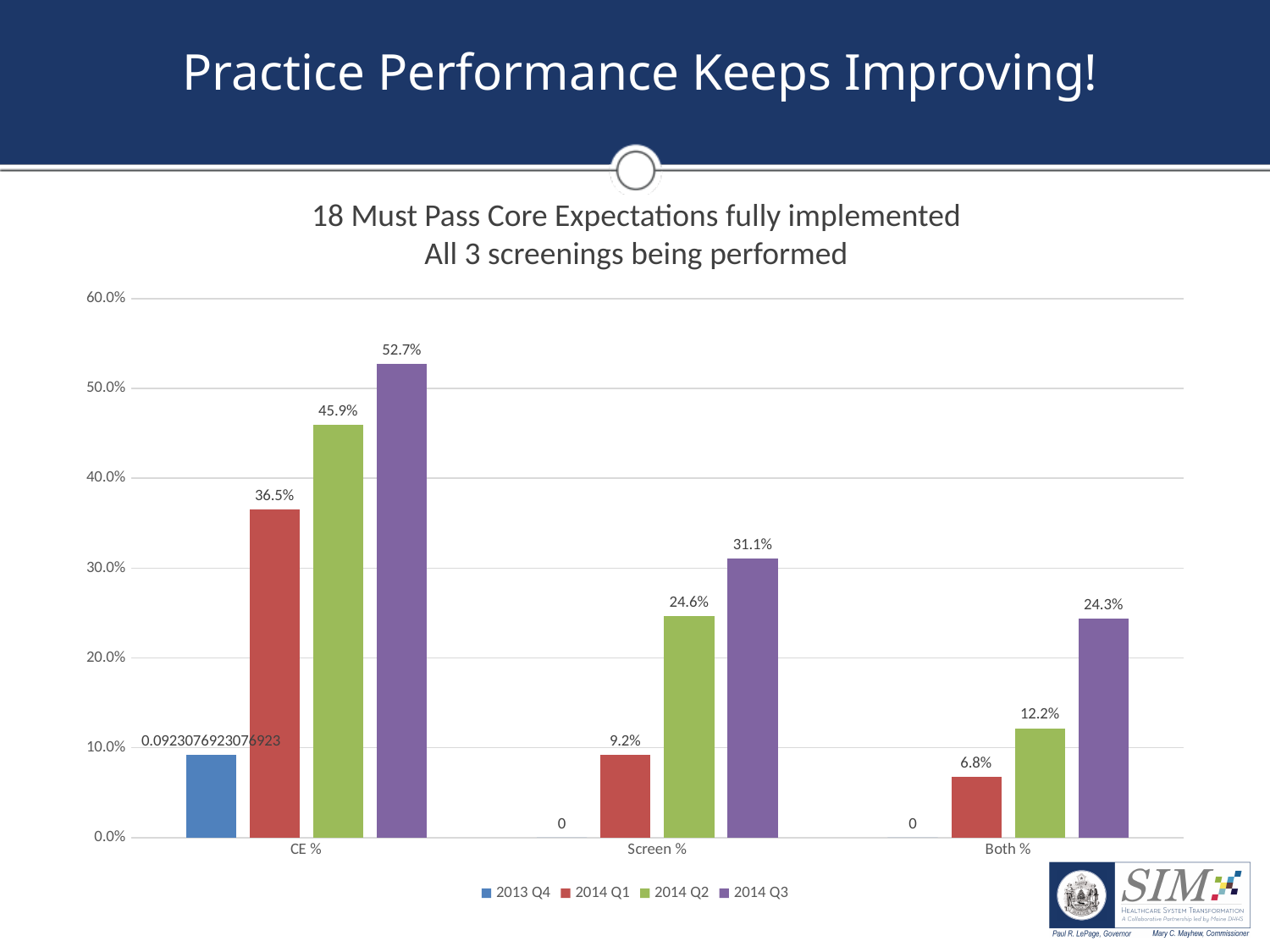
Which category has the lowest 2014 Q3 value? Both % How many categories are shown on the x axis? 3 What is the value for 2014 Q2 in the Both % category? 12.2% What is the data label shown for 2013 Q4 in the CE % category? 0.0923076923076923 How many series does the legend list? 4 What type of chart is shown on the slide? bar chart Do the values for the Both % category rise or fall from 2014 Q1 to 2014 Q3? rise What is the difference between the 2014 Q3 and 2014 Q2 values in the CE % category? 6.8% What is the value for 2014 Q1 in the Screen % category? 9.2% Which is larger: the 2014 Q2 value for Screen % or the 2014 Q3 value for Both %? 2014 Q2 value for Screen % Which series has the highest value in the Screen % category? 2014 Q3 What is the value for 2014 Q3 in the CE % category? 52.7%